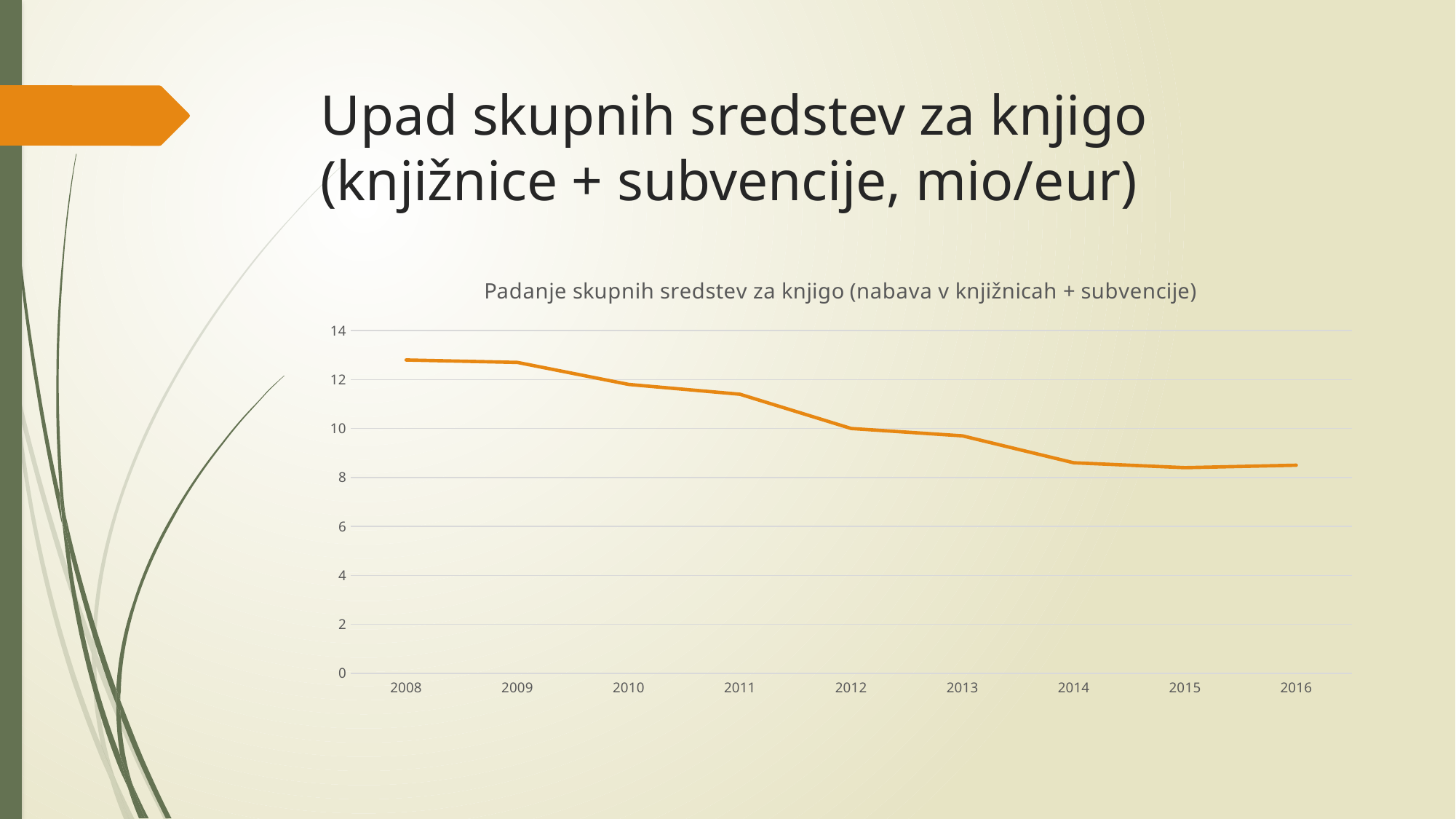
What kind of chart is shown on the slide? line chart Which year has the highest value on the chart? 2008 Is the value for 2011 greater or less than 10? greater Is the value for 2016 greater or less than 8? greater How many years are plotted on the x axis of the chart? 9 Which is larger, the value for 2011 or the value for 2014? 2011 Is the value for 2014 greater or less than 10? less What is the title of the chart? Padanje skupnih sredstev za knjigo (nabava v knjižnicah + subvencije) Do the values rise or fall from 2008 to 2016? fall Which is larger, the value for 2008 or the value for 2016? 2008 What colour is the line in the chart? orange